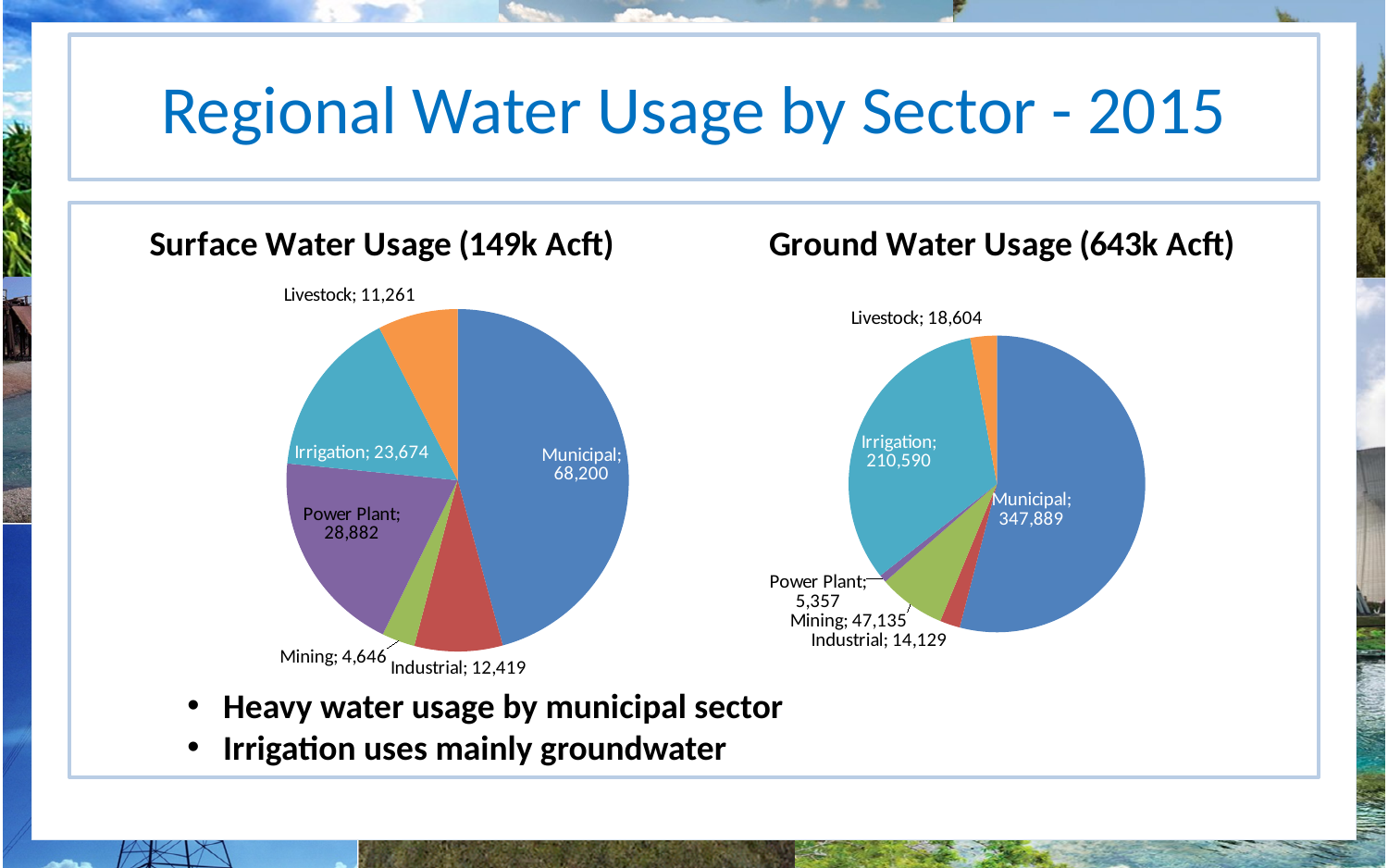
In the Ground Water Usage chart, what is the value for Power Plant? 5,357 How many sectors are shown in the Surface Water Usage chart? 6 In the Ground Water Usage chart, which is larger, Mining or Industrial? Mining What is the title of the chart on the left side of the slide? Surface Water Usage (149k Acft) In the Surface Water Usage chart, which sector has the largest slice? Municipal In the Ground Water Usage chart, which sector has the smallest slice? Power Plant In the Ground Water Usage chart, what is the value for Irrigation? 210,590 In the Surface Water Usage chart, what is the value for Municipal? 68,200 What type of chart is the Ground Water Usage chart? Pie chart In the Surface Water Usage chart, which sector has the smallest slice? Mining In the Surface Water Usage chart, what is the difference between Power Plant and Irrigation? 5,208 In the Ground Water Usage chart, what is the difference between Municipal and Irrigation? 137,299